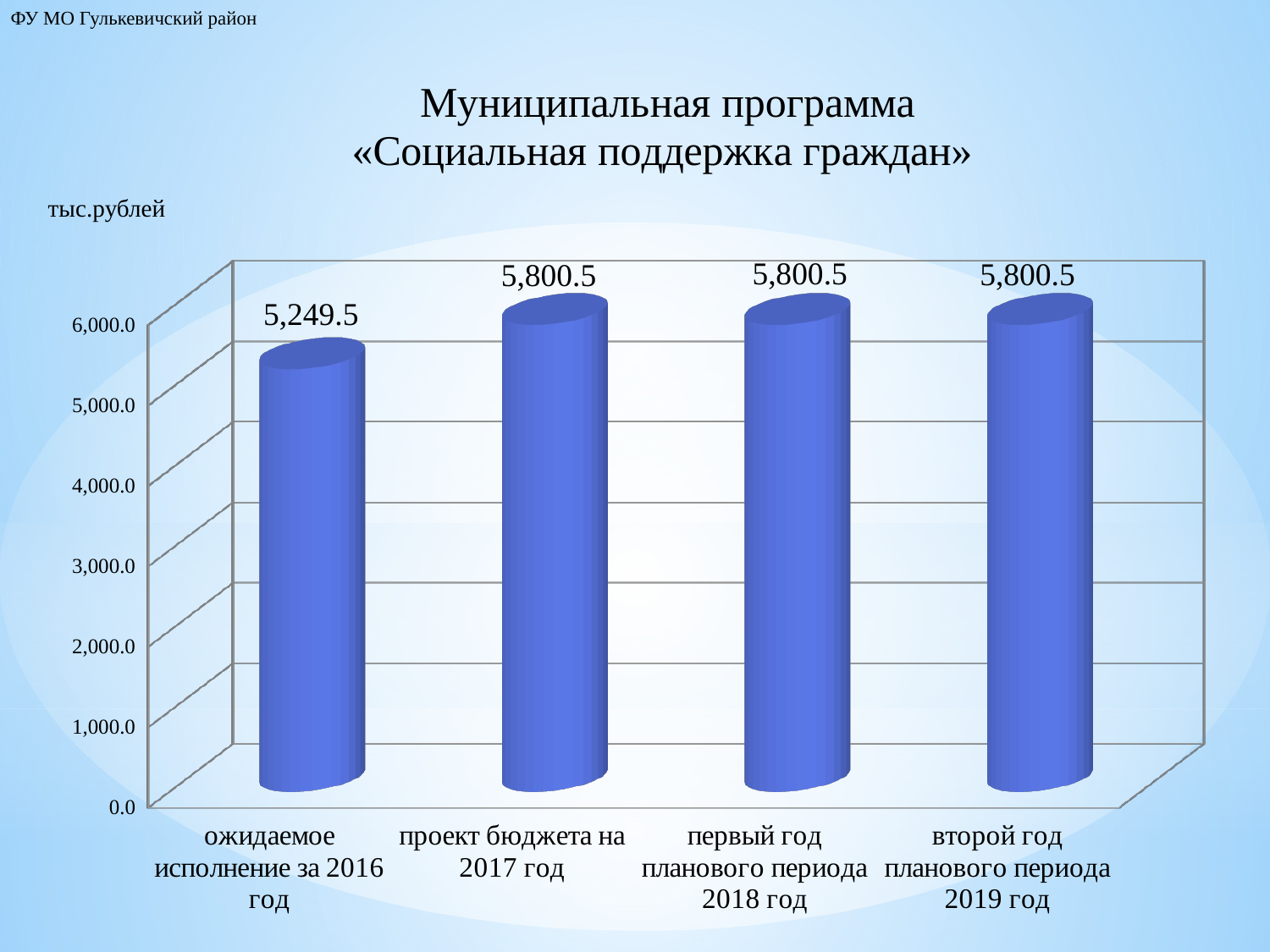
Is the value for «ожидаемое исполнение за 2016 год» greater or less than 5,000.0? greater What kind of chart is shown on the slide? bar chart How many categories are shown on the chart? 4 What is the value for «ожидаемое исполнение за 2016 год»? 5,249.5 What is the highest value shown on the chart? 5,800.5 Which is larger: the value for «ожидаемое исполнение за 2016 год» or the value for «проект бюджета на 2017 год»? проект бюджета на 2017 год What is the value for «второй год планового периода 2019 год»? 5,800.5 What is the value for «первый год планового периода 2018 год»? 5,800.5 What is the difference between the value for 2017 год and the value for 2016 год? 551.0 Which category has the lowest value? ожидаемое исполнение за 2016 год In what units are the values on the chart expressed? тыс.рублей What is the value for «проект бюджета на 2017 год»? 5,800.5